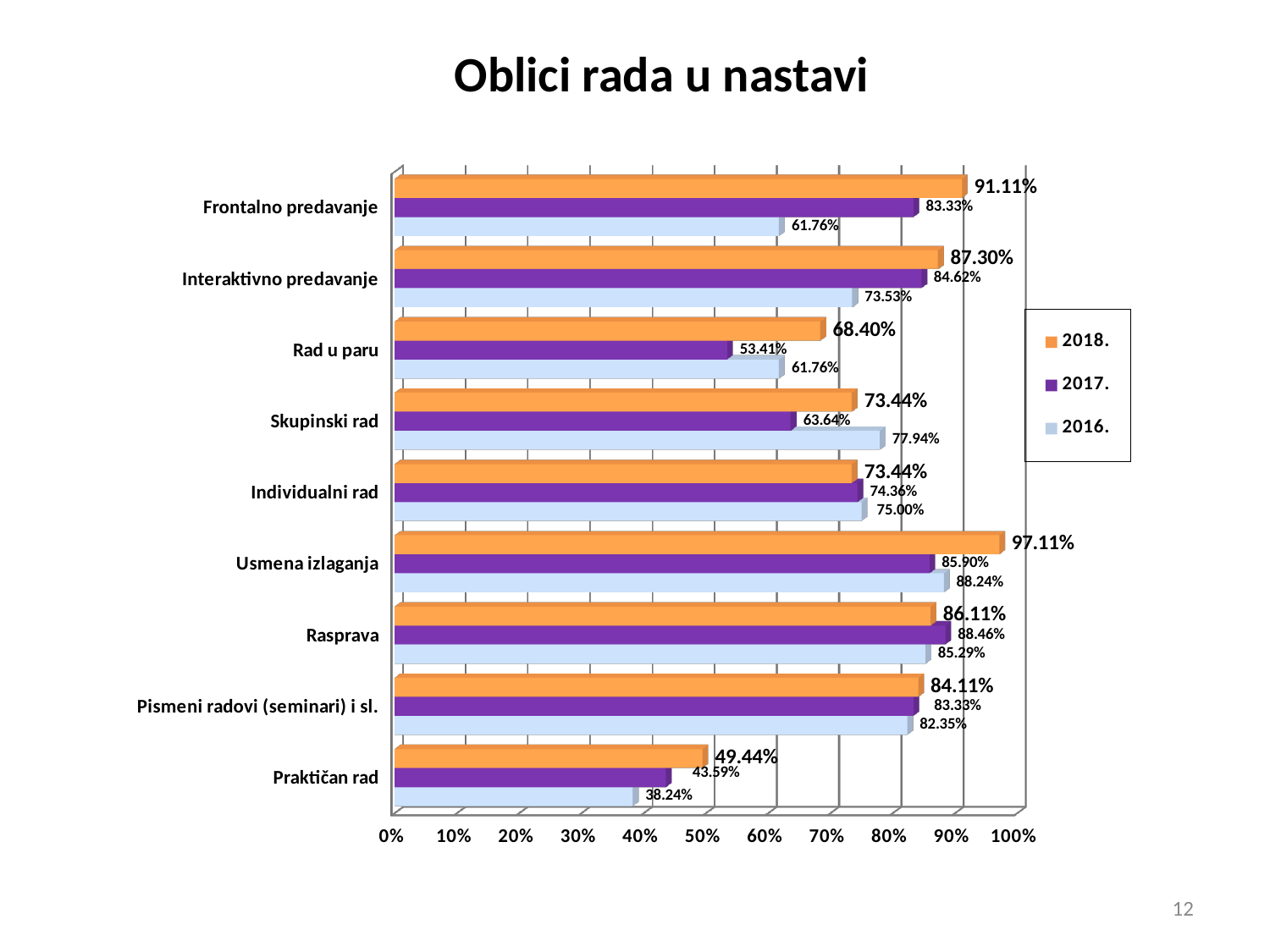
Which is larger for Skupinski rad: the 2016. value or the 2017. value? 2016. How many categories are shown on the chart? 9 What is the title of the chart? Oblici rada u nastavi What is the difference between the 2018. and 2016. values for Frontalno predavanje? 29.35% Which category has the highest value in the 2018. series? Usmena izlaganja What is the value for Rad u paru in the 2017. series? 53.41% What is the value for Praktičan rad in the 2016. series? 38.24% Which category has the lowest value in the 2017. series? Praktičan rad What kind of chart is shown on the slide? bar chart How many series does the legend list? 3 What is the value for Frontalno predavanje in the 2018. series? 91.11% Is the 2018. value for Rad u paru greater or less than 60%? greater